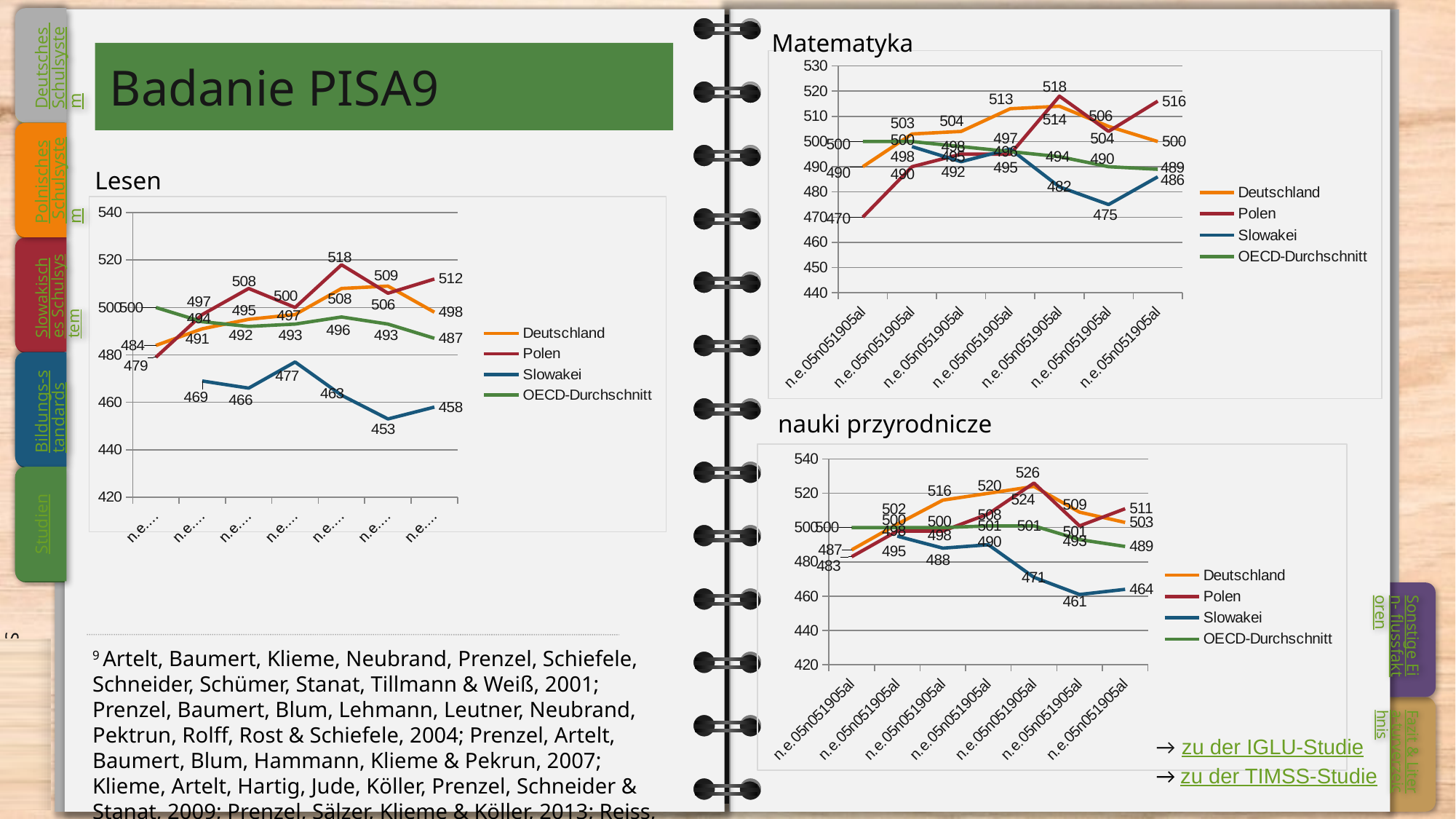
In the "Lesen" chart, what is the value of the Polen series at the last point on the x axis? 512 In the "Lesen" chart, what is the highest value reached by the Polen series? 518 What kind of chart is the "Lesen" chart? line chart In the "Matematyka" chart, what is the value of the Deutschland series at the last point on the x axis? 500 In the "Lesen" chart, what is the difference between the Polen value (512) and the Deutschland value (498) at the last point? 14 In the "Matematyka" chart, what is the lowest value of the Slowakei series? 475 How many series does the legend of the "Matematyka" chart list? 4 In the "nauki przyrodnicze" chart, what is the lowest value of the Slowakei series? 461 In the "Lesen" chart, what is the lowest value of the Slowakei series? 453 How many points along the x axis does the "Matematyka" chart have? 7 In the "Matematyka" chart, which series has the higher value at the last point: Polen or Deutschland? Polen In the "nauki przyrodnicze" chart, what is the highest value reached by the Deutschland series? 524